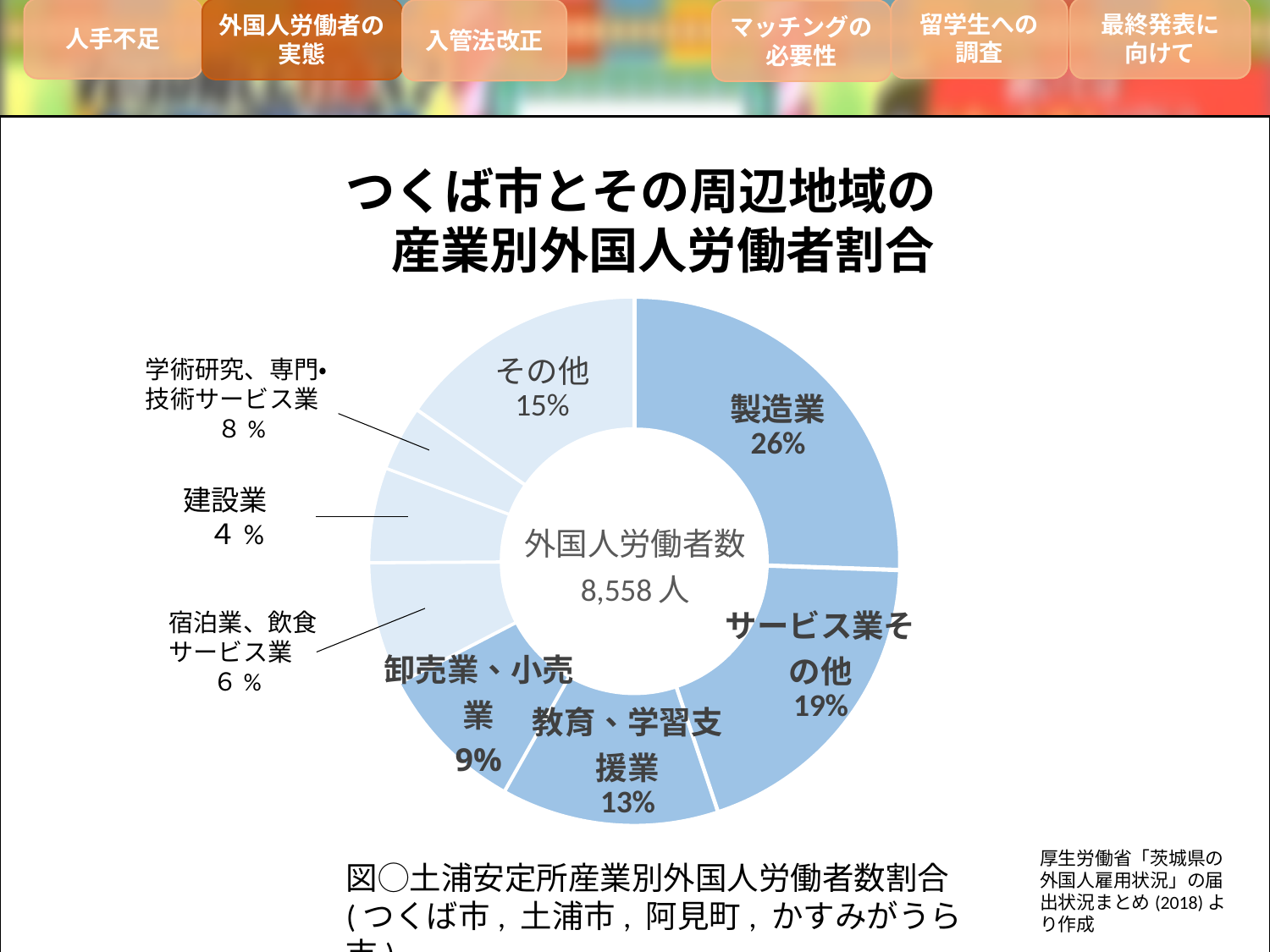
How many industry categories are shown in the chart? 8 What is the combined share of 宿泊業、飲食サービス業 and 学術研究、専門・技術サービス業? 14% Which is larger, the share for 教育、学習支援業 or the share for 卸売業、小売業? 教育、学習支援業 What type of chart is shown on the slide? Donut (pie) chart What is the share labelled その他 in the chart? 15% What is the value shown for 建設業? 4% What percentage of foreign workers are in 製造業 according to the chart? 26% What share does サービス業その他 have in the chart? 19% What is the total number of foreign workers shown in the center of the chart? 8,558人 What is the difference in percentage points between 製造業 and サービス業その他? 7 Which industry has the largest share in the chart? 製造業 Which industry has the smallest share in the chart? 建設業